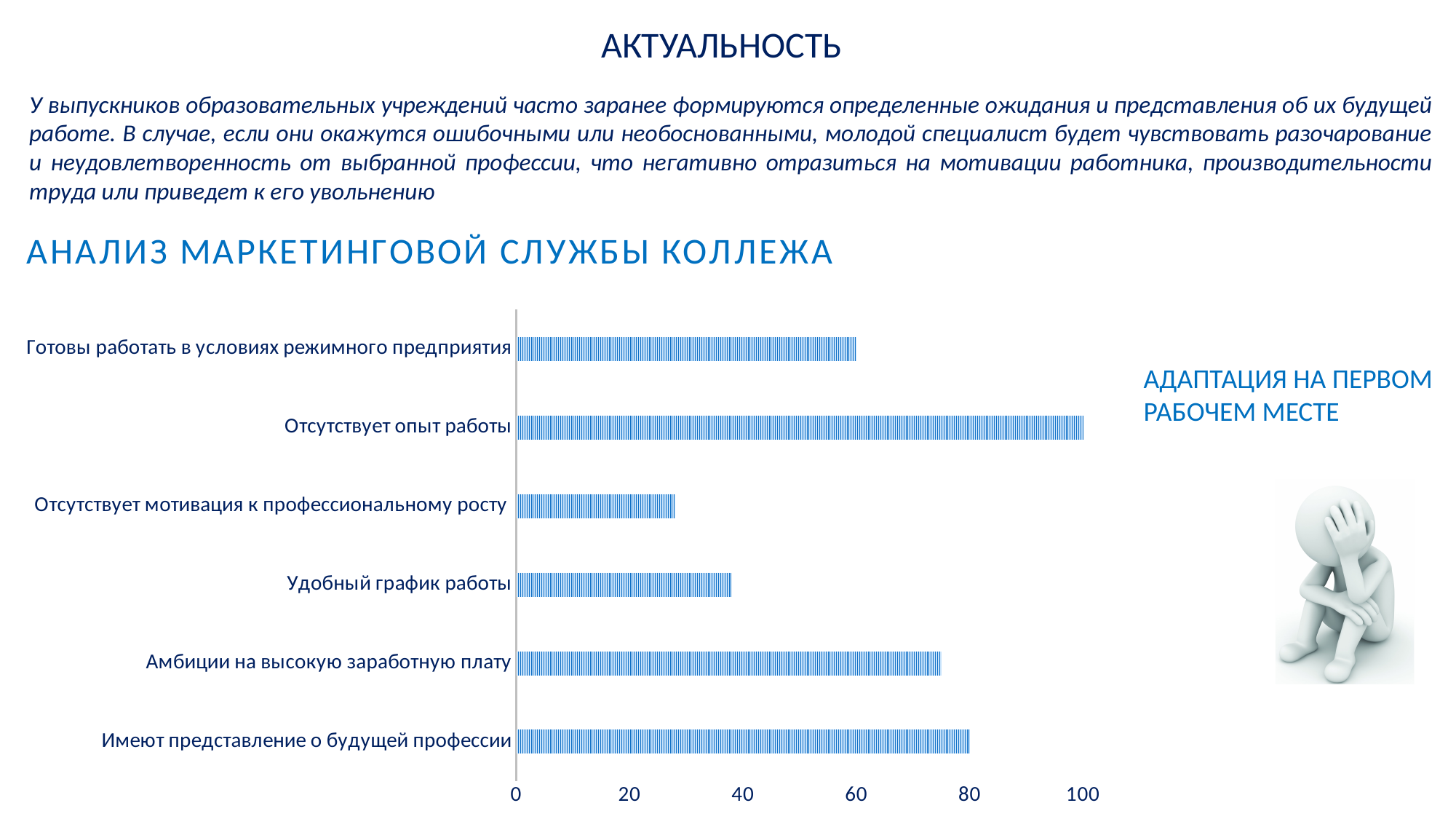
How many categories does the bar chart show? 6 What is the value for "Отсутствует опыт работы"? 100 What is the difference between the values for "Отсутствует опыт работы" and "Готовы работать в условиях режимного предприятия"? 40 Which category has the lowest value in the bar chart? Отсутствует мотивация к профессиональному росту Is the value for "Отсутствует мотивация к профессиональному росту" greater or less than 40? less What is the highest tick value shown on the horizontal axis of the chart? 100 What is the value for "Имеют представление о будущей профессии"? 80 Which category has the highest value in the bar chart? Отсутствует опыт работы What is the value for "Готовы работать в условиях режимного предприятия"? 60 Is the value for "Амбиции на высокую заработную плату" greater or less than 60? greater What kind of chart is shown on the slide? bar chart Which is larger: the value for "Амбиции на высокую заработную плату" or the value for "Удобный график работы"? Амбиции на высокую заработную плату